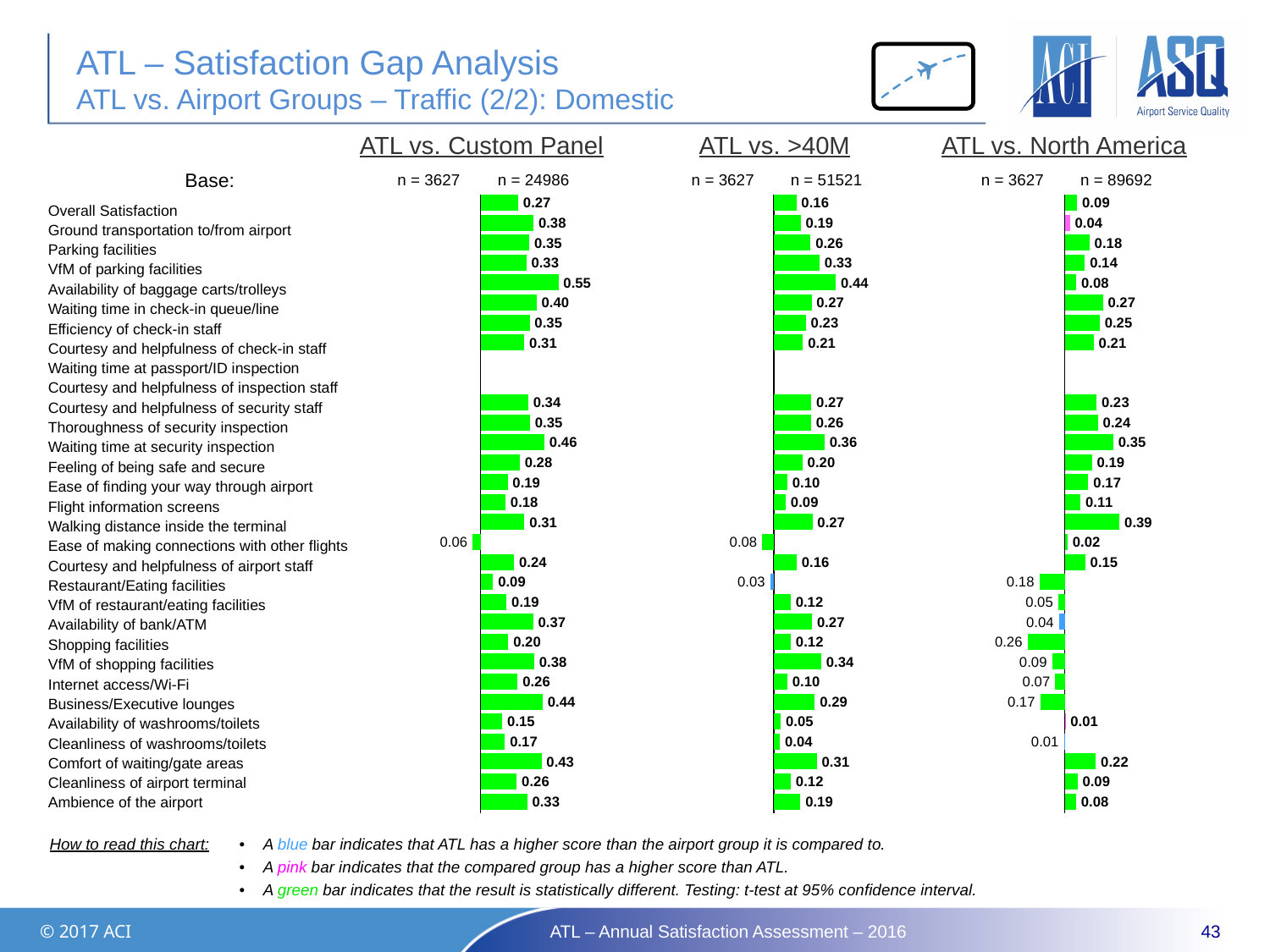
In the ATL vs. Custom Panel chart, what is the difference between the values for Business/Executive lounges and Availability of washrooms/toilets? 0.29 In the ATL vs. >40M chart, which item has the largest bar? Availability of baggage carts/trolleys What type of chart is used on this slide? Bar chart In the ATL vs. Custom Panel chart, what is the value for Overall Satisfaction? 0.27 In the ATL vs. Custom Panel chart, which item has the largest bar? Availability of baggage carts/trolleys In the ATL vs. >40M chart, which is larger: the value for VfM of shopping facilities or the value for Shopping facilities? VfM of shopping facilities In the ATL vs. North America chart, which item has the largest bar? Walking distance inside the terminal What is the base (n) for the airport group in the ATL vs. North America chart? n = 89692 In the ATL vs. North America chart, what is the value for Shopping facilities? 0.26 According to the legend, what does a green bar indicate? The result is statistically different In the ATL vs. >40M chart, what is the value for Waiting time at security inspection? 0.36 In the ATL vs. North America chart, what is the value for Walking distance inside the terminal? 0.39